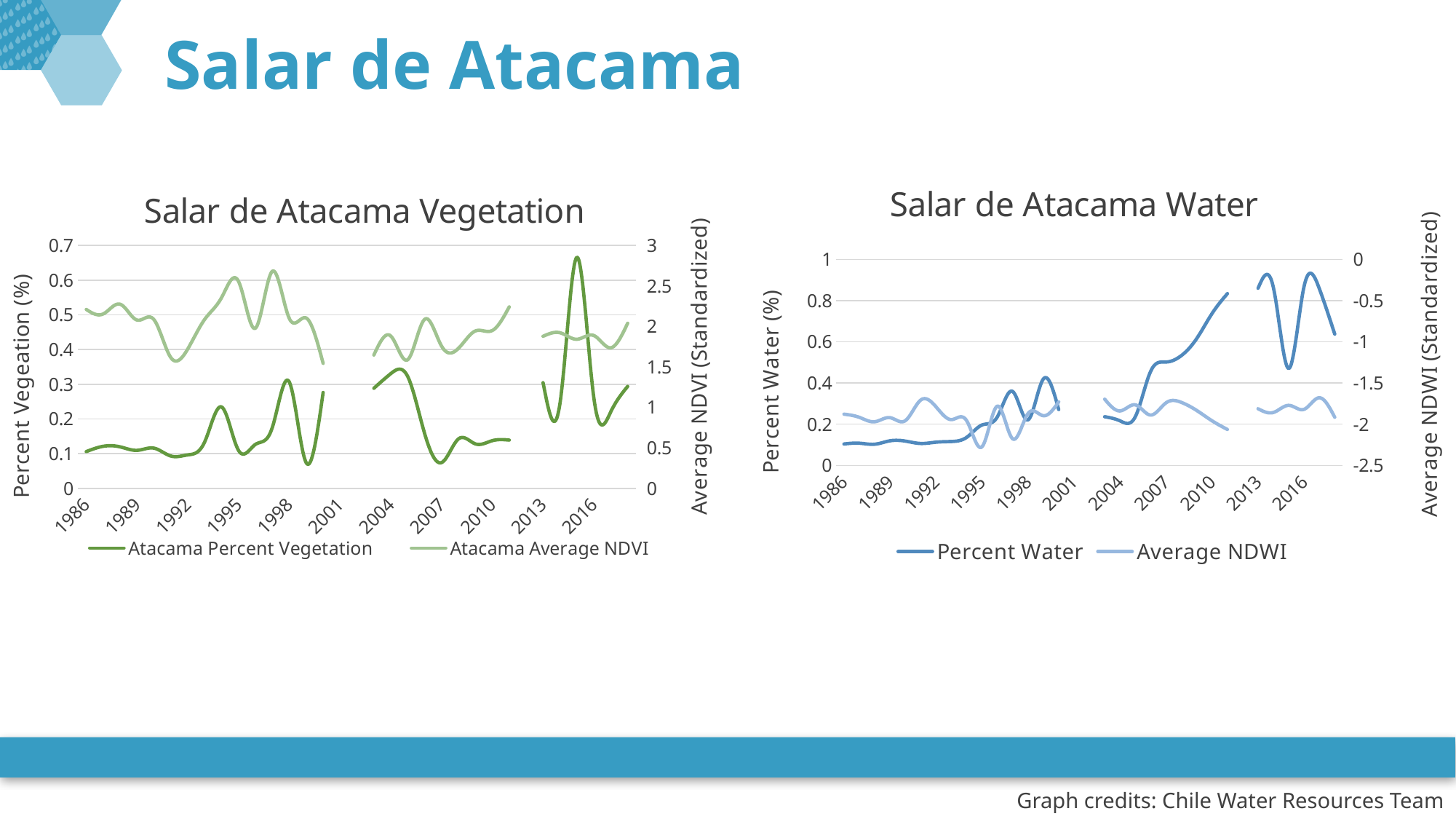
How many series does the legend of the Salar de Atacama Vegetation chart list? 2 In the Salar de Atacama Vegetation chart, is the peak Atacama Percent Vegetation value around 2015 greater or less than 0.6? greater In the Salar de Atacama Water chart, does the Percent Water series rise or fall between 2004 and 2010? rise How many year labels are shown on the x axis of the Salar de Atacama Water chart? 11 What kind of chart is the Salar de Atacama Water chart? line chart In the Salar de Atacama Vegetation chart, what are the two series named in the legend? Atacama Percent Vegetation and Atacama Average NDVI In the Salar de Atacama Vegetation chart, is the Atacama Percent Vegetation value in 1986 greater or less than 0.2? less What kind of chart is the Salar de Atacama Vegetation chart? line chart How many series does the legend of the Salar de Atacama Water chart list? 2 In the Salar de Atacama Water chart, is the Percent Water value in 1986 greater or less than 0.2? less In the Salar de Atacama Water chart, what is the label of the right-hand vertical axis? Average NDWI (Standardized)